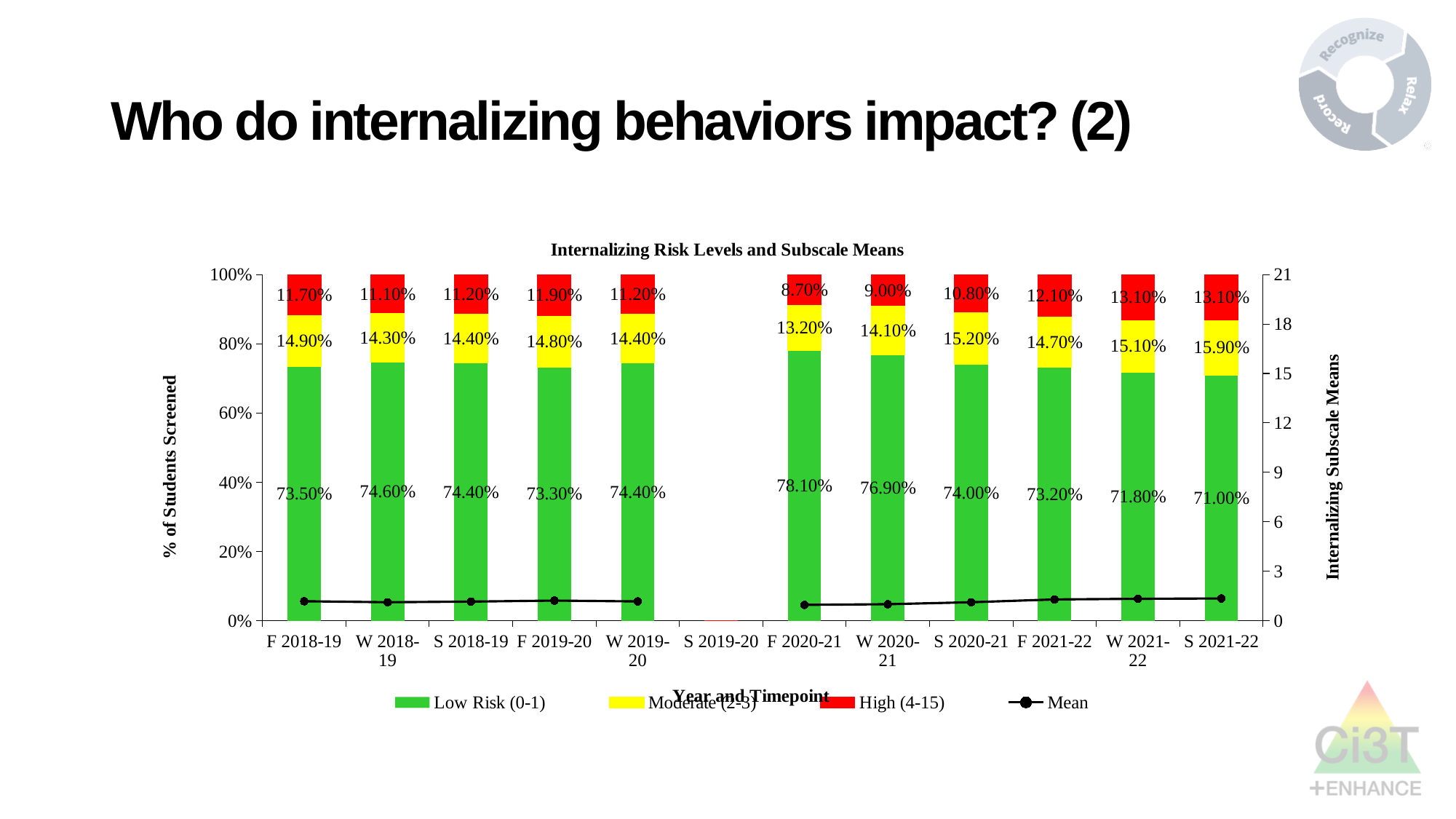
What is the total of the stacked bar for F 2020-21? 100.00% Which timepoint has the lowest High (4-15) percentage? F 2020-21 What is the Low Risk (0-1) percentage for F 2020-21? 78.10% Which has a larger Low Risk (0-1) percentage, W 2018-19 or F 2019-20? W 2018-19 What is the difference between the Low Risk (0-1) percentage for F 2020-21 and for S 2021-22? 7.10% Is the Mean value for F 2018-19 greater or less than 3 on the right-hand axis? less Which timepoint has the highest Low Risk (0-1) percentage? F 2020-21 Which timepoint has the lowest Low Risk (0-1) percentage? S 2021-22 What is the Moderate (2-3) percentage for S 2020-21? 15.20% How many series does the legend list? 4 What is the title of the chart? Internalizing Risk Levels and Subscale Means What is the High (4-15) percentage for W 2021-22? 13.10%